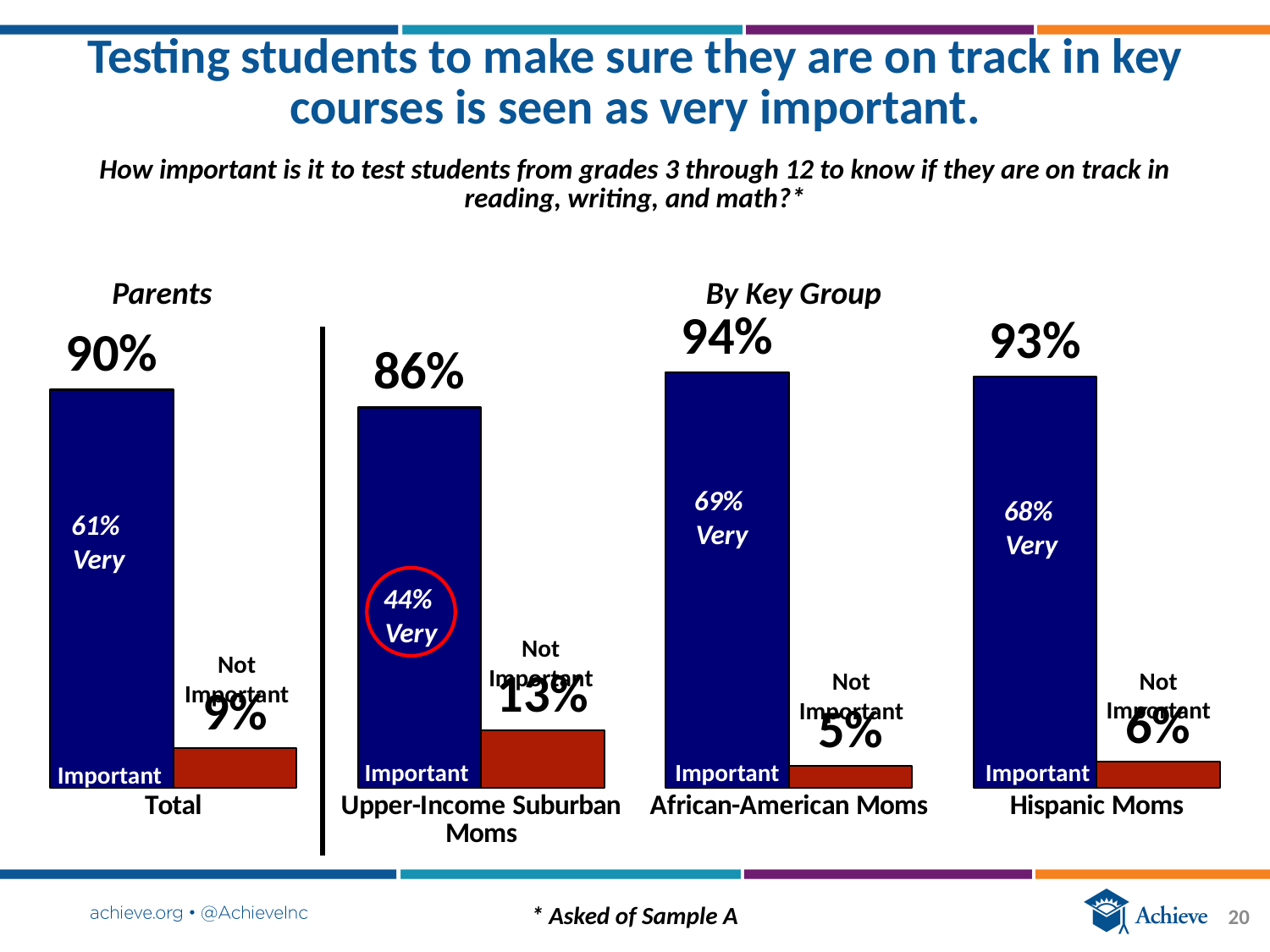
What percentage of African-American Moms says testing is Very important? 69% Which group's Very important value is circled in red on the chart? Upper-Income Suburban Moms What kind of chart is shown on the slide? Bar chart Which group has the highest Important percentage? African-American Moms Which is larger, the Not Important percentage for the Total group or for Hispanic Moms? Total How many groups are shown in the chart? 4 What is the difference between the Very important percentage for the Total group and for Upper-Income Suburban Moms? 17% What percentage of the Total group says testing is Important? 90% What percentage of Upper-Income Suburban Moms says testing is Not Important? 13% Which group has the lowest Important percentage? Upper-Income Suburban Moms What percentage of Hispanic Moms says testing is Important? 93% What is the difference between the Important percentage for African-American Moms and for Upper-Income Suburban Moms? 8%